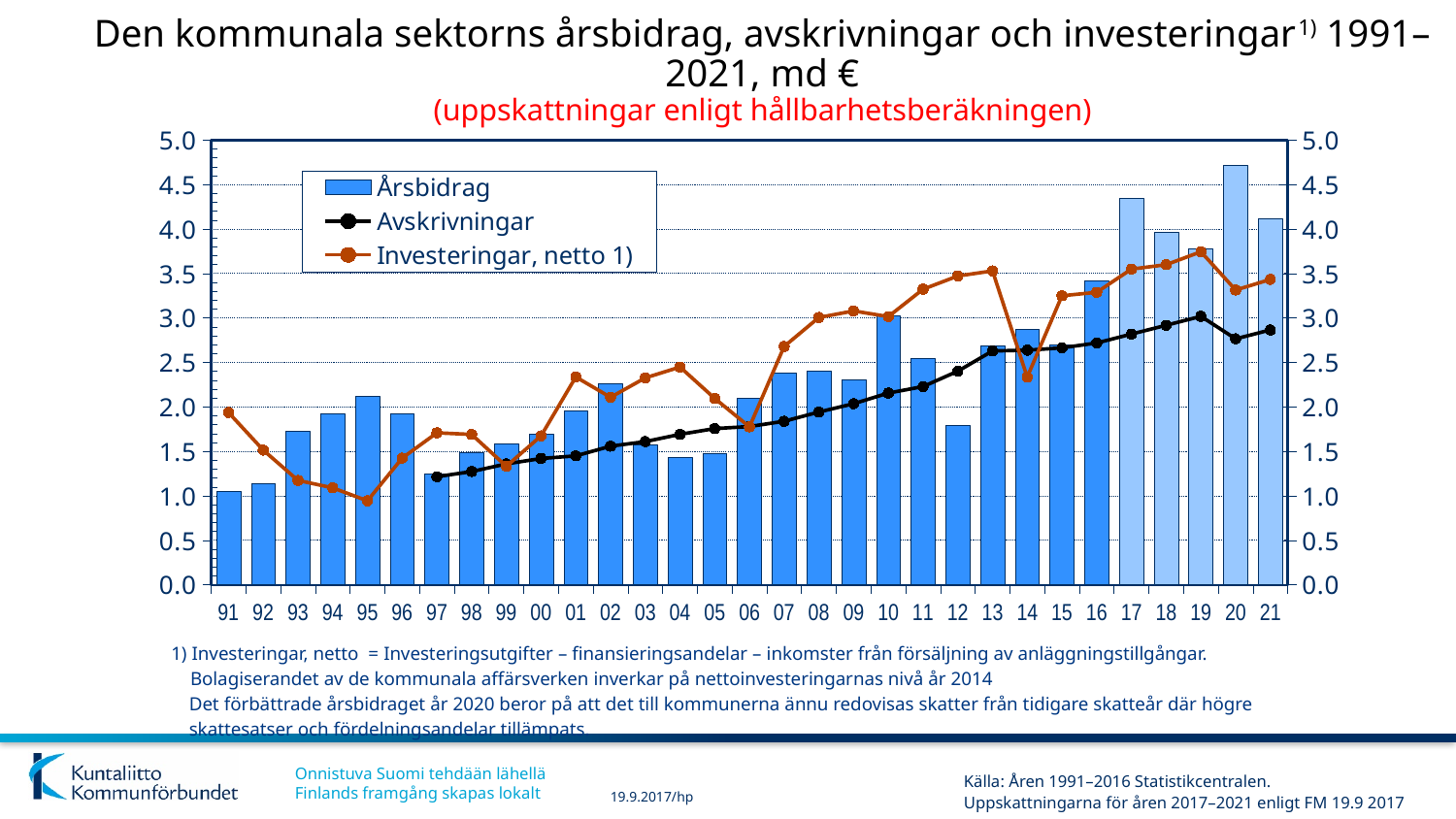
Which year has the lowest Årsbidrag bar? 91 Is the Avskrivningar value for 97 greater or less than 1.5? less What kind of chart is shown on the slide? A combined bar and line chart Is the Investeringar, netto value for 14 greater or less than 2.5? less How many years are shown along the x axis? 31 Does the Avskrivningar line generally rise or fall from 97 to 21? rise Is the Årsbidrag value for 20 greater or less than 4.5? greater How many series does the legend list? 3 Which year has the highest Årsbidrag bar? 20 Which year has the lowest value for Investeringar, netto? 95 Which is larger, the Årsbidrag bar for 11 or for 12? 11